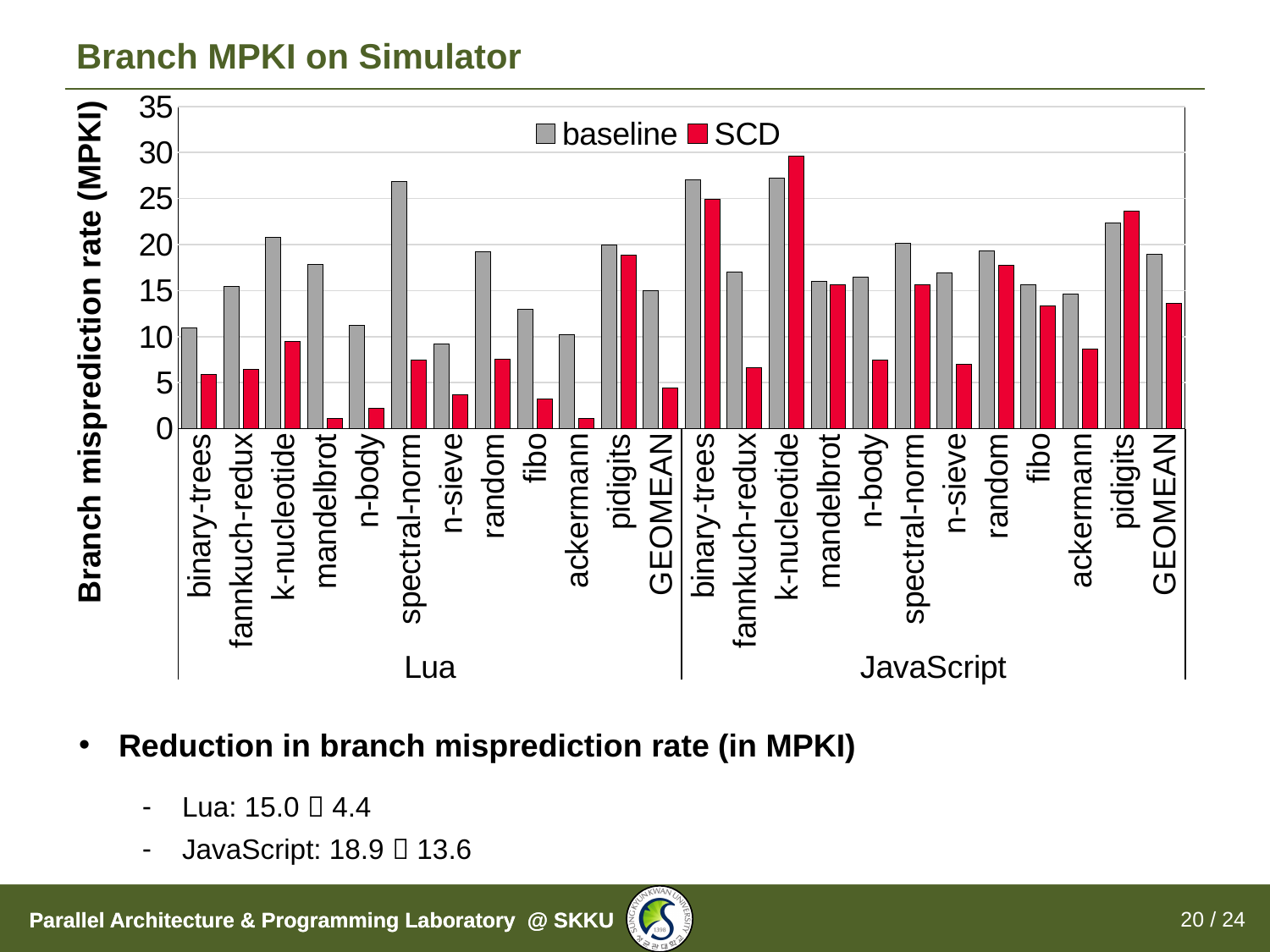
Is the baseline value for spectral-norm in the Lua group greater or less than 25? greater What is the label of the y axis? Branch misprediction rate (MPKI) Is the SCD value for mandelbrot in the Lua group greater or less than 5? less How many series does the legend list? 2 What is the SCD GEOMEAN value for JavaScript? 13.6 Which benchmark has the highest SCD bar on the chart? k-nucleotide (JavaScript) What kind of chart is shown on the slide? bar chart What is the baseline GEOMEAN value for Lua? 15.0 For k-nucleotide in the JavaScript group, which is larger, the baseline or the SCD value? SCD How many benchmark categories are plotted in the Lua group? 12 By how much does the GEOMEAN branch misprediction rate for Lua drop from baseline to SCD? 10.6 What are the two series named in the legend? baseline and SCD